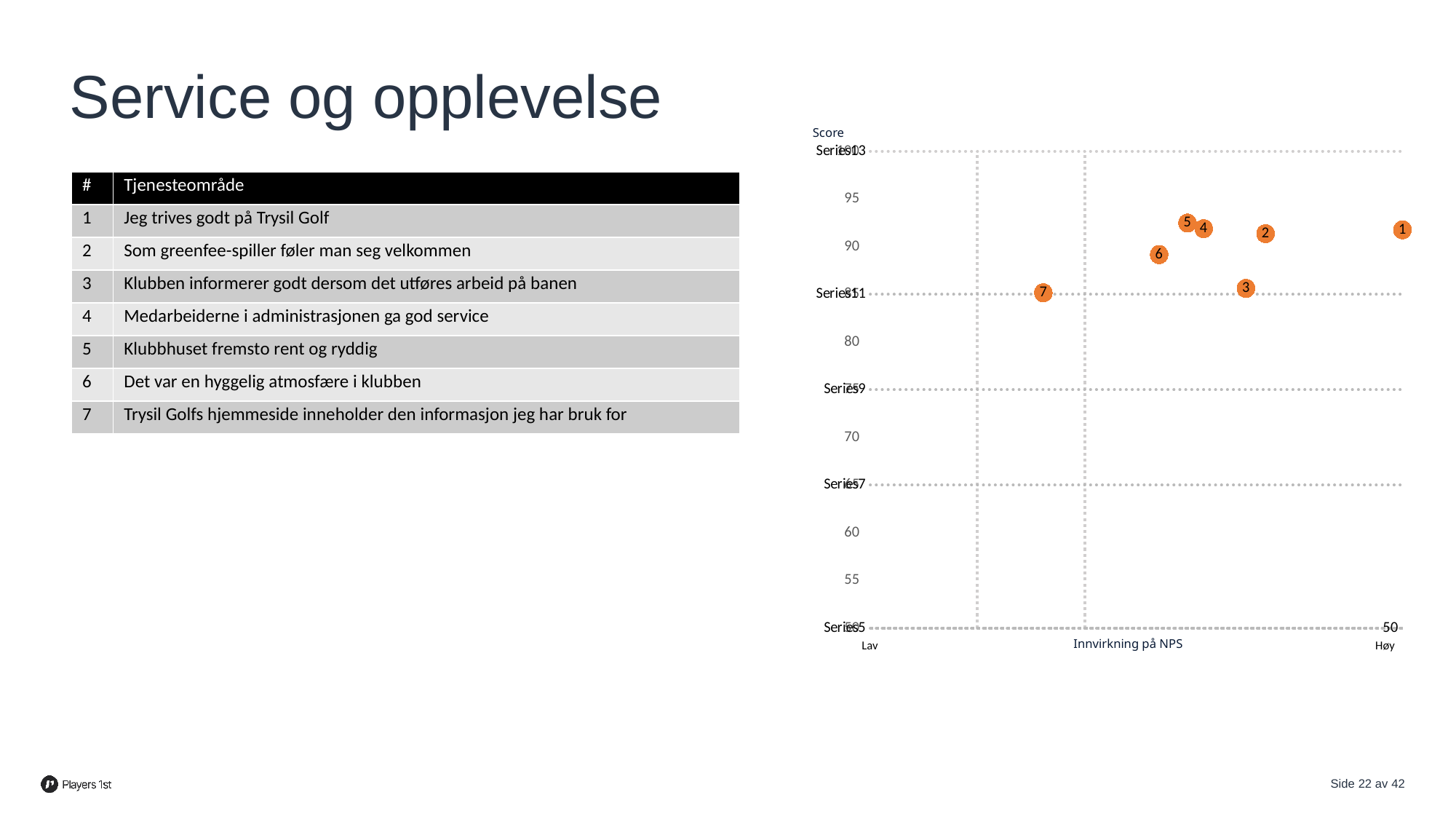
What kind of chart is shown on the slide? Scatter chart How many data points are plotted in the chart? 7 Is the score for point 5 greater or less than 90? greater Is the score for point 3 greater or less than 90? less Which point is furthest to the right on the 'Innvirkning på NPS' axis (highest impact)? Point 1 Is the score for point 7 greater or less than 90? less Which point has a higher score, point 2 or point 3? Point 2 Which point is furthest to the left on the 'Innvirkning på NPS' axis (lowest impact)? Point 7 Which point has a higher score, point 5 or point 7? Point 5 What is the title of the horizontal axis of the chart? Innvirkning på NPS What is the title of the vertical axis of the chart? Score